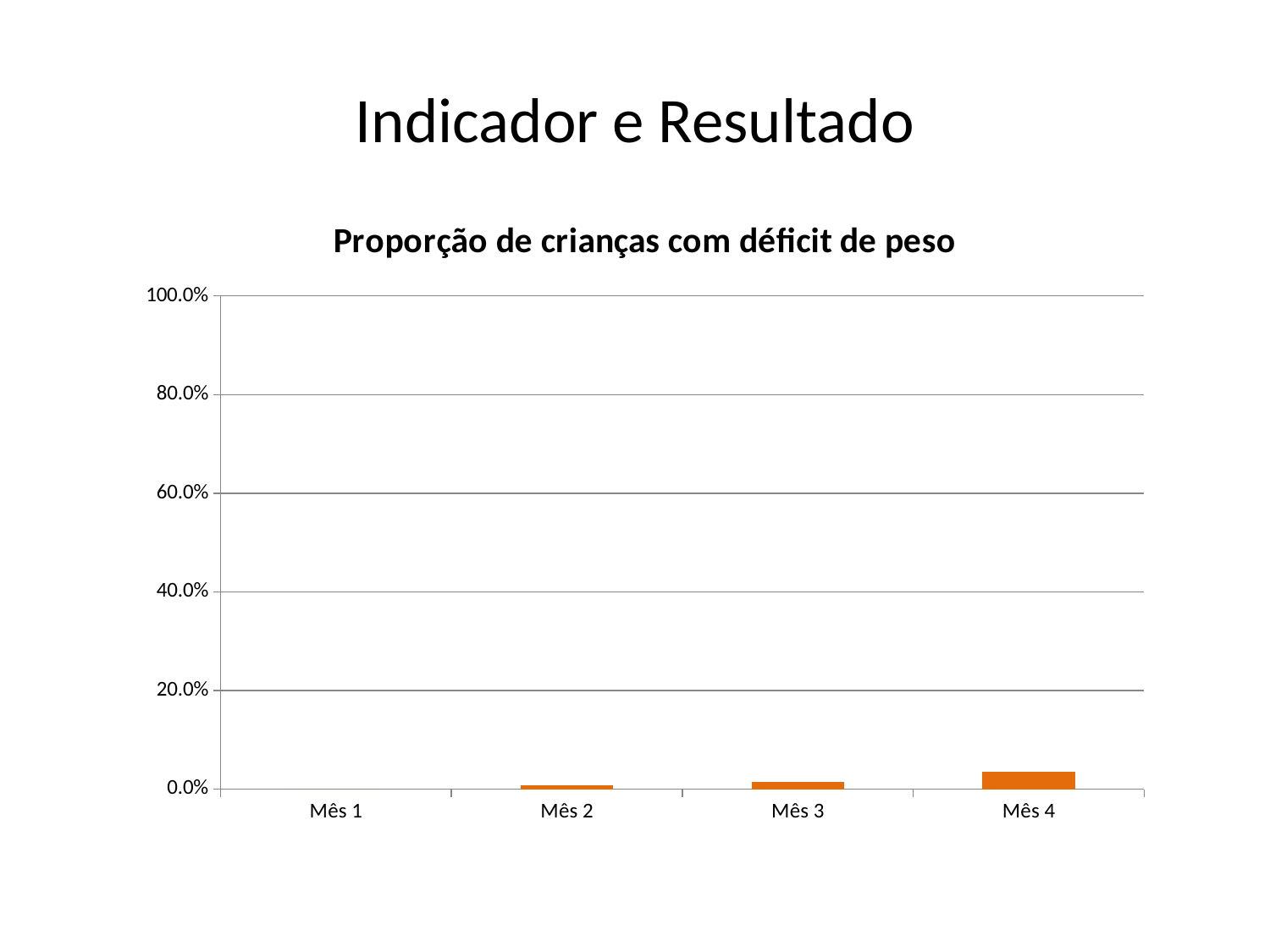
Do the values rise or fall from Mês 1 to Mês 4? rise Is the value for Mês 4 greater or less than 20.0%? less Which is larger, the value for Mês 3 or the value for Mês 1? Mês 3 Which is larger, the value for Mês 4 or the value for Mês 2? Mês 4 Is the value for Mês 3 greater or less than 20.0%? less How many categories are plotted on the x axis of the chart? 4 What is the title of the chart? Proporção de crianças com déficit de peso What colour are the bars in the chart? orange Which category has the highest value in the chart? Mês 4 What kind of chart is shown on the slide? bar chart Which category has the lowest value in the chart? Mês 1